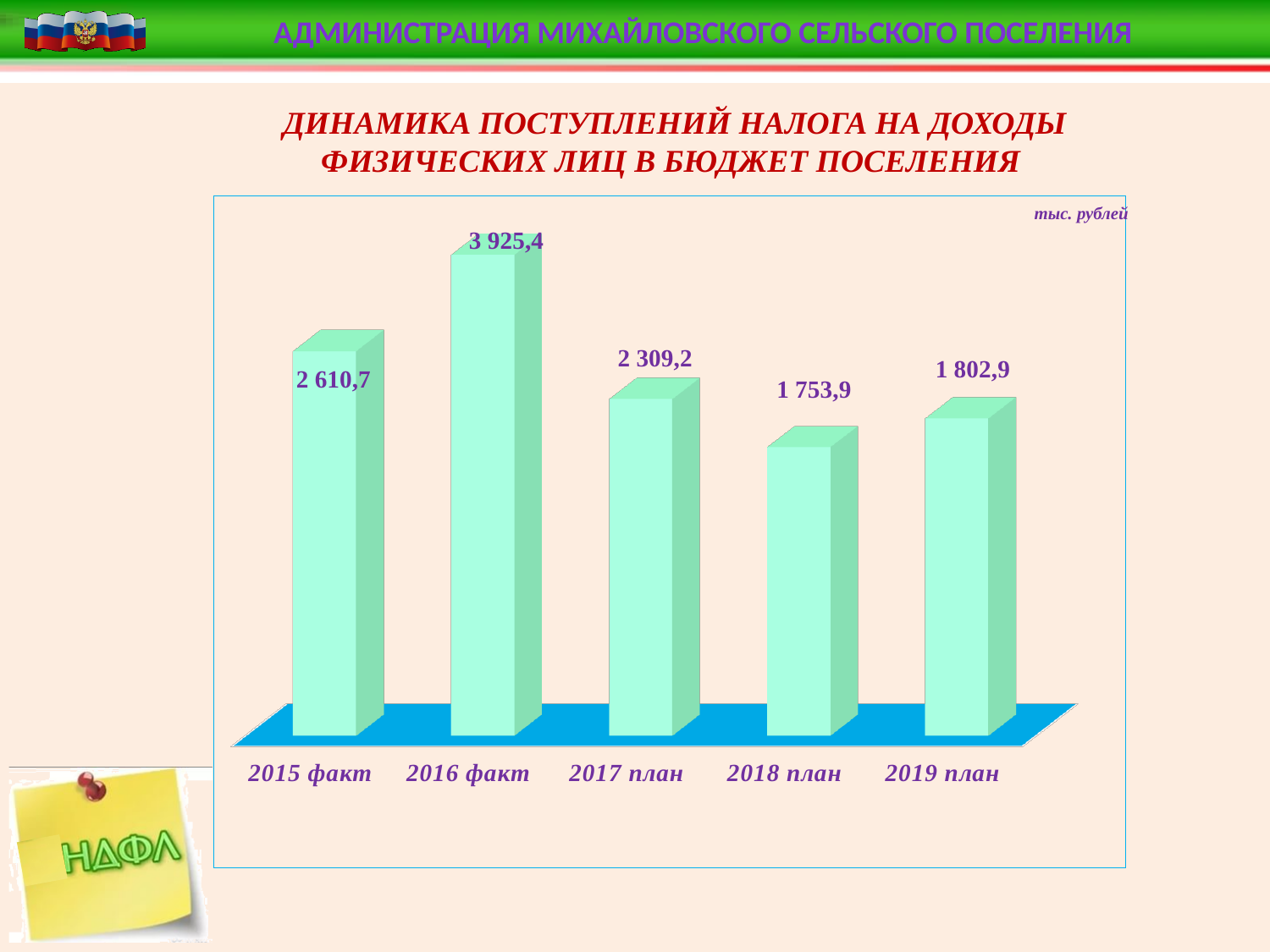
Do the values rise or fall from 2016 факт to 2018 план? Fall What is the value for 2019 план? 1 802,9 Which category has the lowest value? 2018 план What kind of chart is shown on the slide? Bar chart What is the value for 2018 план? 1 753,9 What is the difference between the values for 2019 план and 2018 план? 49,0 How many categories are shown on the x axis? 5 What unit of measurement is indicated in the top right corner of the chart? тыс. рублей Which is larger, the value for 2017 план or the value for 2019 план? 2017 план What is the difference between the values for 2016 факт and 2015 факт? 1 314,7 What is the value for 2016 факт? 3 925,4 Which category has the highest value? 2016 факт